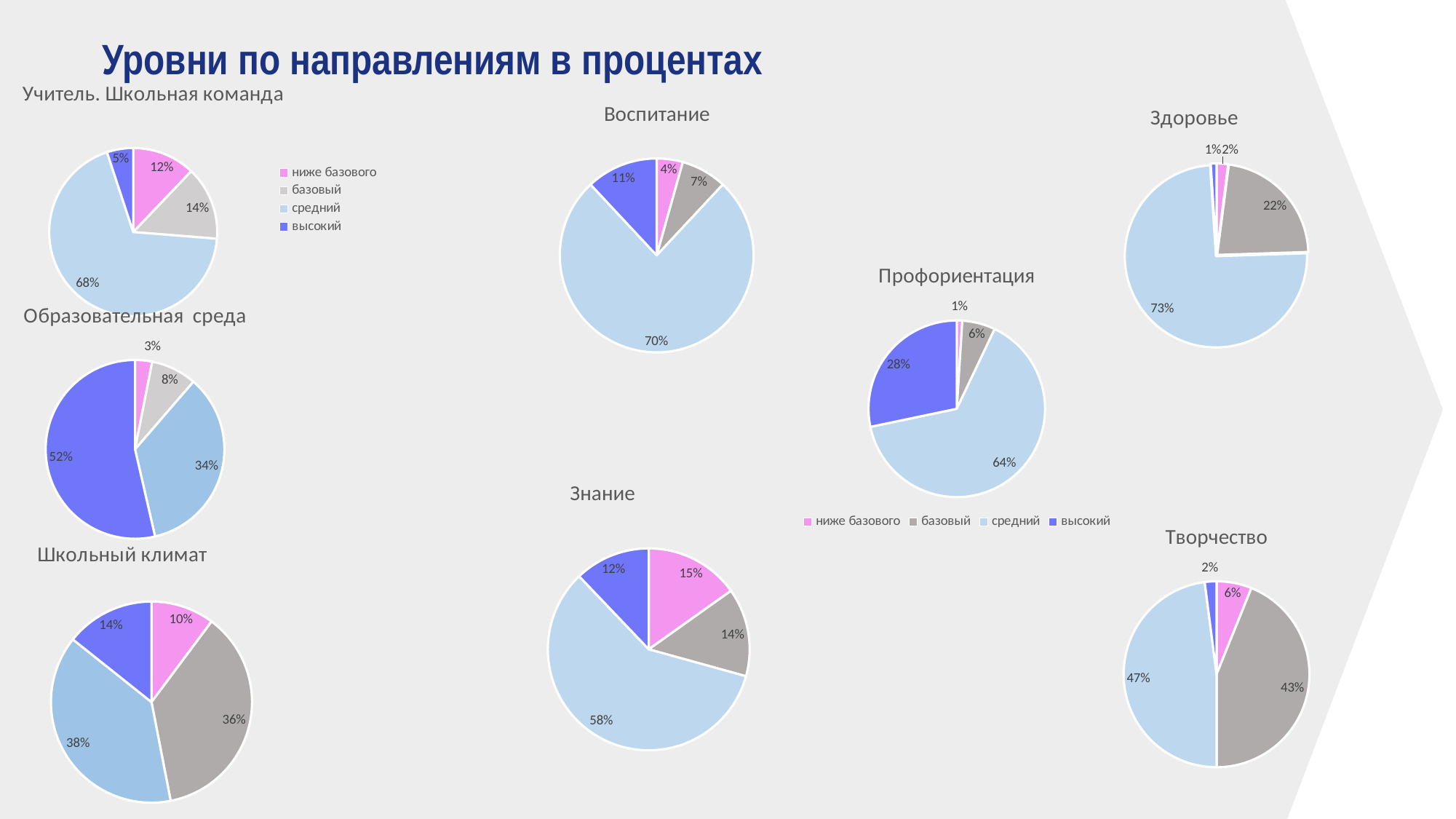
In the Образовательная среда pie chart, which level has the largest share? высокий How many series does the legend next to the top-left pie chart list? 4 What type of chart is used for Воспитание? pie chart In the Творчество pie chart, what is the difference between the средний and базовый shares? 4% In the Воспитание pie chart, what percentage is shown for the средний slice? 70% In the Здоровье pie chart, what percentage is shown for the базовый slice? 22% In the top-left pie chart under Учитель. Школьная команда, what percentage is shown for the средний slice? 68% In the Школьный климат pie chart, which level has the smallest share? ниже базового In the Знание pie chart, which is larger: the ниже базового slice or the высокий slice? ниже базового In the Знание pie chart, what percentage is shown for the ниже базового slice? 15% In the Школьный климат pie chart, what is the combined share of базовый and средний? 74% In the Профориентация pie chart, what percentage is shown for the высокий slice? 28%